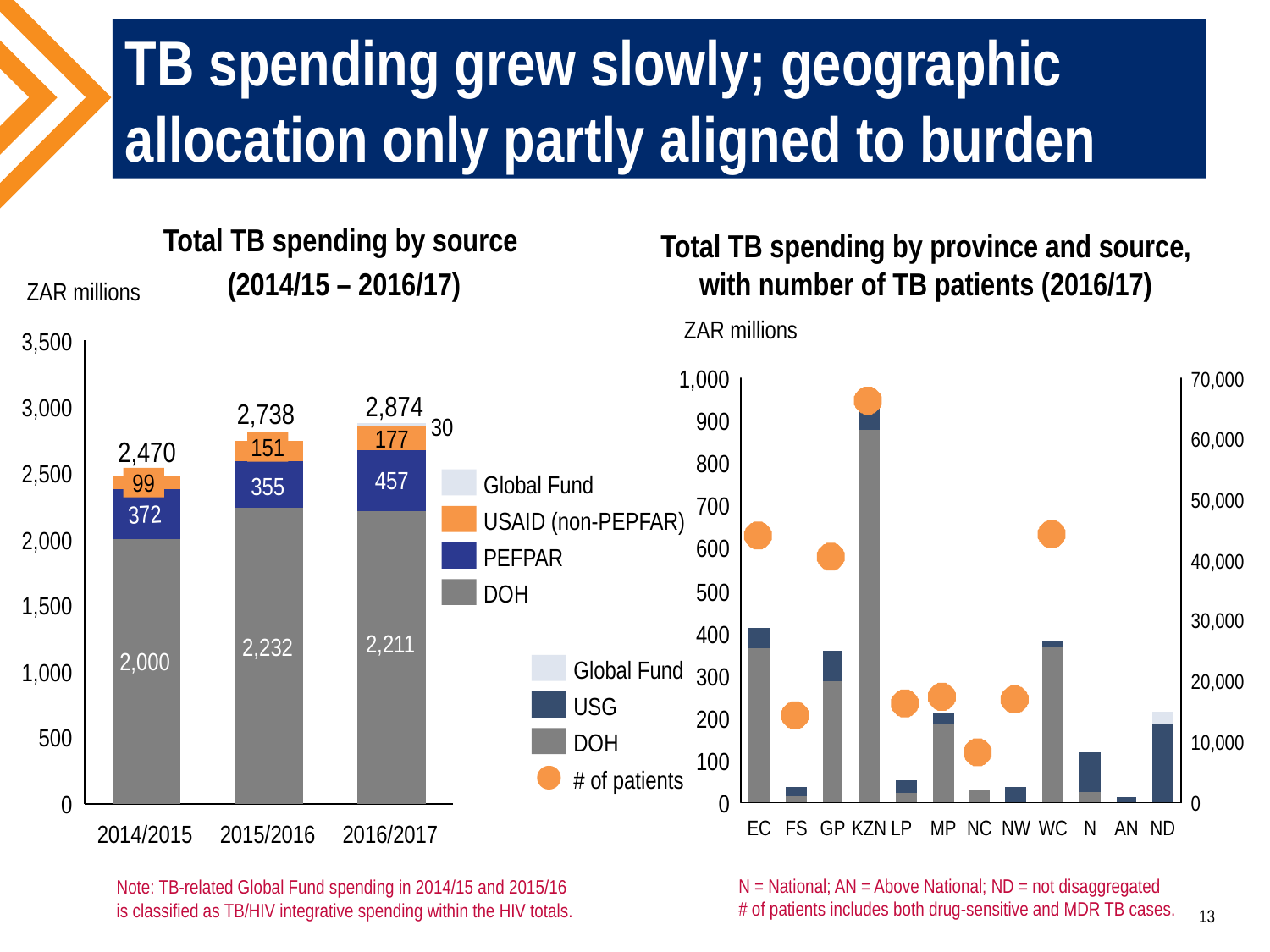
On the left chart, Total TB spending by source, how many series does the legend list? 4 On the left chart, Total TB spending by source, what is the difference between the total spending in 2016/2017 and 2014/2015? 404 On the left chart, Total TB spending by source, what was the PEFPAR spending in 2016/2017? 457 On the right chart, Total TB spending by province and source, which has the larger spending bar, EC or FS? EC On the right chart, Total TB spending by province and source, how many provinces/categories are shown on the x axis? 12 On the left chart, Total TB spending by source, what was the DOH spending in 2014/2015? 2,000 On the right chart, Total TB spending by province and source, which category has the highest TB spending bar? KZN On the left chart, Total TB spending by source, what was the Global Fund spending in 2016/2017? 30 On the right chart, Total TB spending by province and source, is the spending bar for KZN greater or less than 800? greater On the left chart, Total TB spending by source, does total TB spending rise or fall from 2014/2015 to 2016/2017? rise On the left chart, Total TB spending by source, which year had the highest total TB spending? 2016/2017 On the left chart, Total TB spending by source, what was the total TB spending in 2015/2016? 2,738